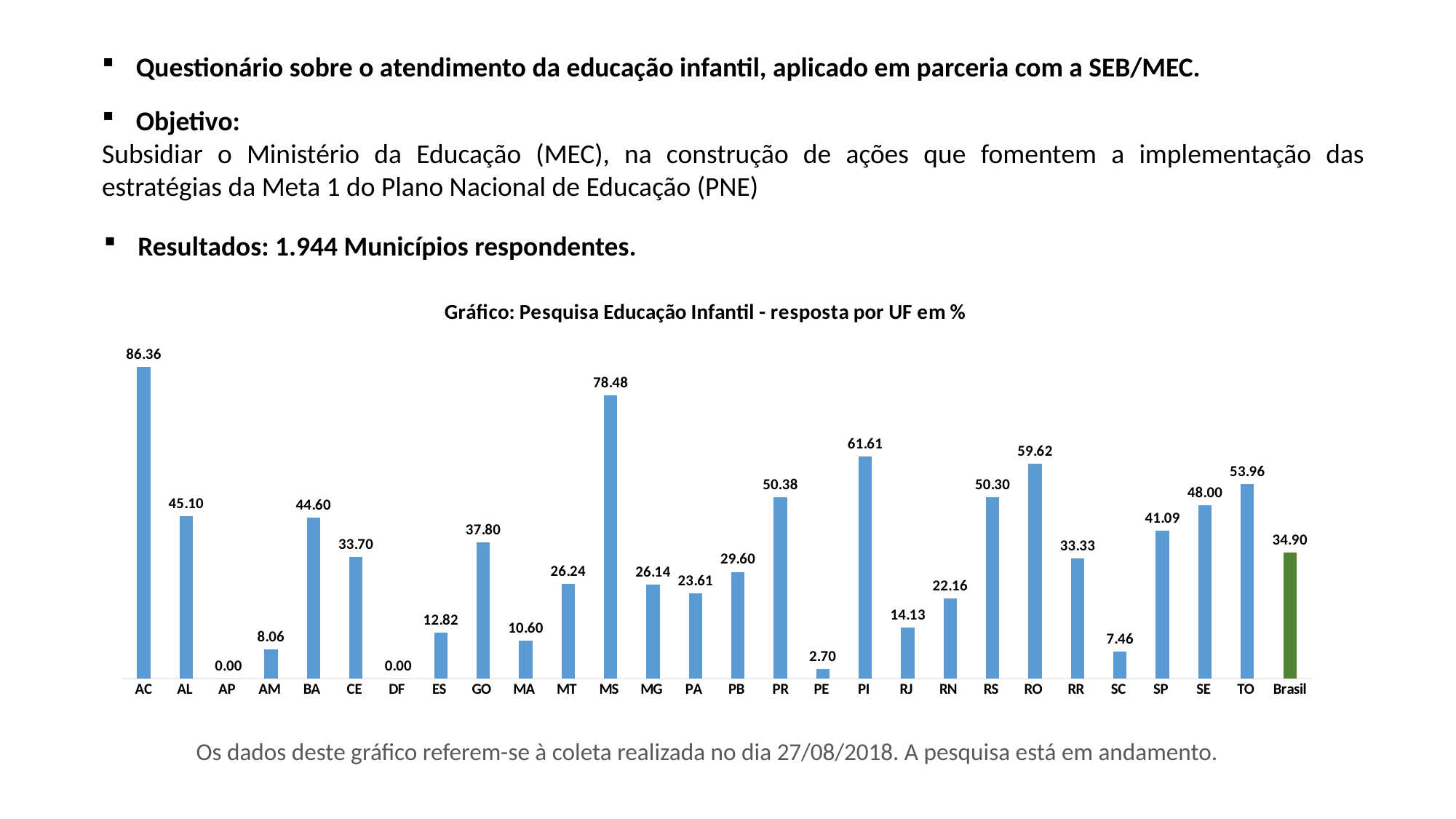
What type of chart is shown on the slide? Bar chart How many bars are plotted in the chart? 28 What is the value shown for Brasil in the chart? 34.90 Which has a larger value, GO or CE? GO What is the value for PE in the chart? 2.70 What is the difference between the values for AC and MS? 7.88 What is the title of the chart? Gráfico: Pesquisa Educação Infantil - resposta por UF em % Which two UFs have a value of 0.00 in the chart? AP and DF What is the difference between the values for PI and RO? 1.99 Which has a larger value, TO or SE? TO What is the value for MS in the chart? 78.48 Which UF has the highest value in the chart? AC